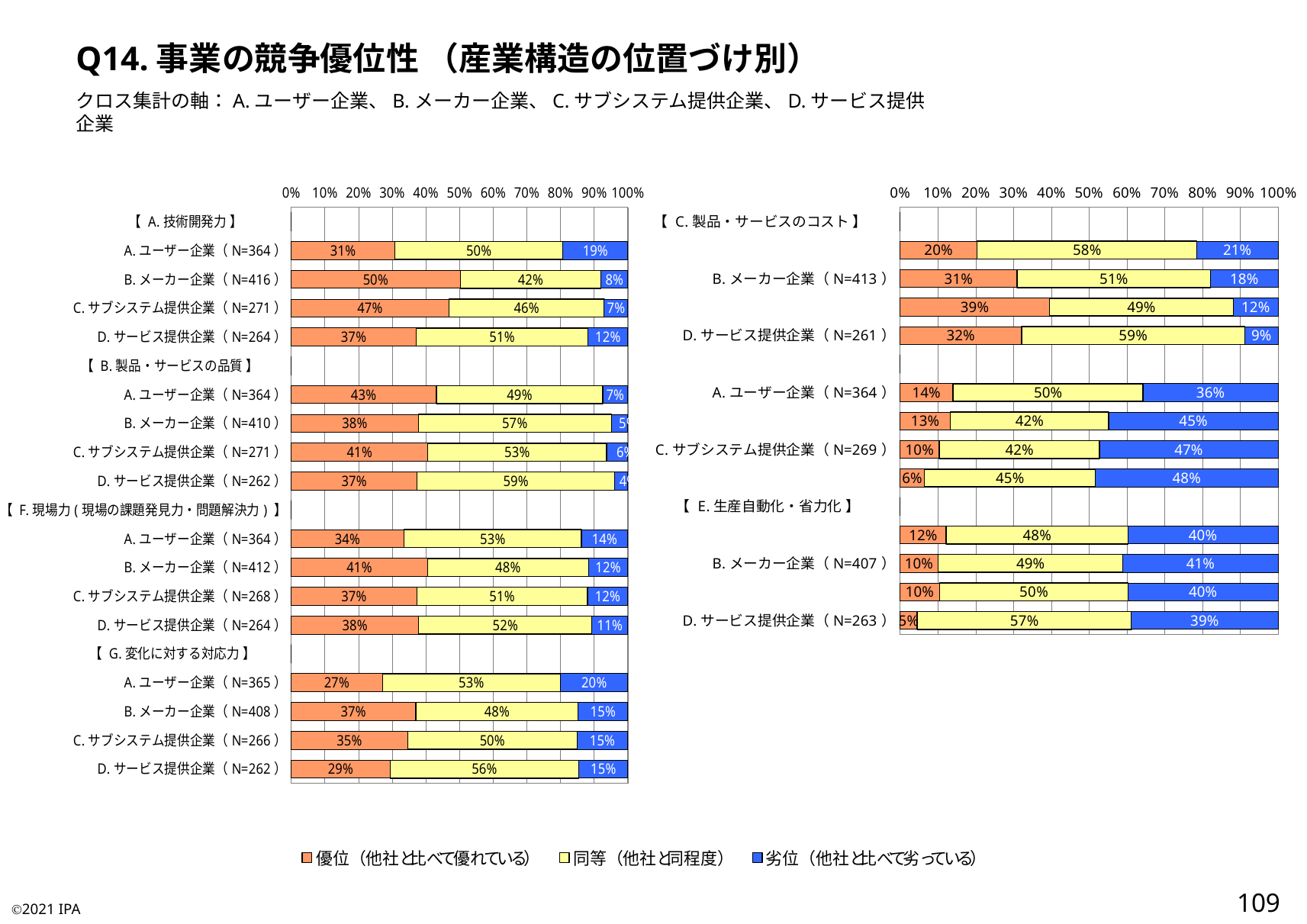
In the left chart, under 【F. 現場力】, which has the larger 優位 value: B. メーカー企業 or C. サブシステム提供企業? B. メーカー企業 Which legend entry is shown in blue? 劣位（他社と比べて劣っている） In the left chart, under 【B. 製品・サービスの品質】, how much larger is the 同等 value than the 優位 value for D. サービス提供企業 (N=262)? 22 percentage points In the left chart, under 【G. 変化に対する対応力】, which company type has the lowest 優位 share? A. ユーザー企業 What kind of chart is shown on the slide? Stacked bar chart In the left chart, under 【A. 技術開発力】, what is the 優位 value for B. メーカー企業 (N=416)? 50% In the left chart, under 【G. 変化に対する対応力】, what is the 劣位 value for A. ユーザー企業 (N=365)? 20% In the left chart, under 【A. 技術開発力】, what is the total of the three segments for A. ユーザー企業 (N=364)? 100% In the right chart, under 【C. 製品・サービスのコスト】, what is the 劣位 value for B. メーカー企業 (N=413)? 18% In the left chart, under 【A. 技術開発力】, which company type has the highest 優位 share? B. メーカー企業 In the right chart, under 【E. 生産自動化・省力化】, what is the 同等 value for D. サービス提供企業 (N=263)? 57% How many series does the legend list? 3